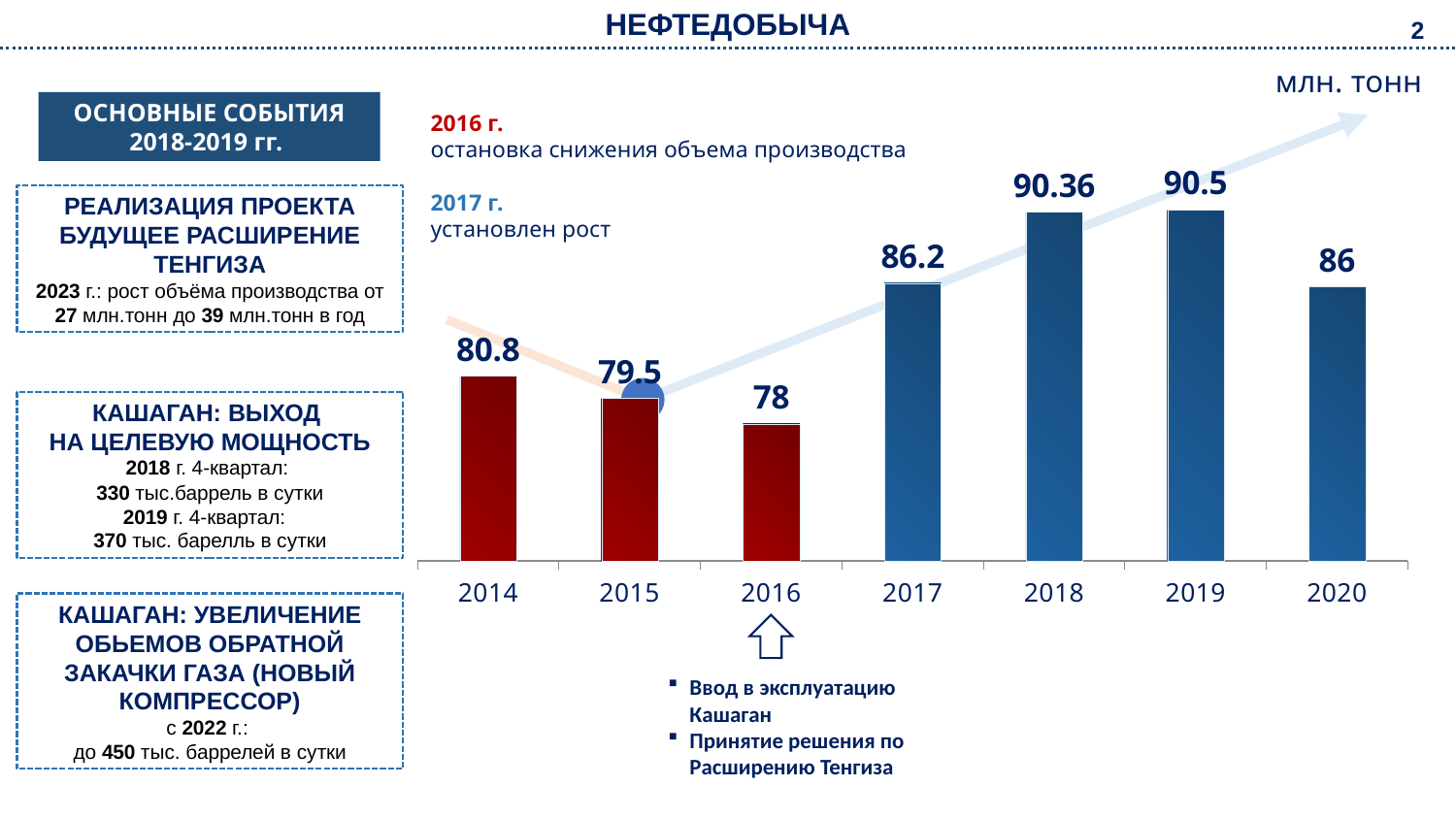
What kind of chart is this? bar chart Which is larger, the value for 2017 or the value for 2020? 2017 What is the value for 2018? 90.36 What is the difference between the values for 2014 and 2015? 1.3 Which year has the lowest value? 2016 Which year has the highest value? 2019 What unit is shown in the top right corner of the chart? млн. тонн What is the difference between the values for 2017 and 2016? 8.2 Do the values rise or fall from 2014 to 2016? fall What is the value for 2020? 86 How many years are shown on the x axis? 7 What is the value for 2014? 80.8